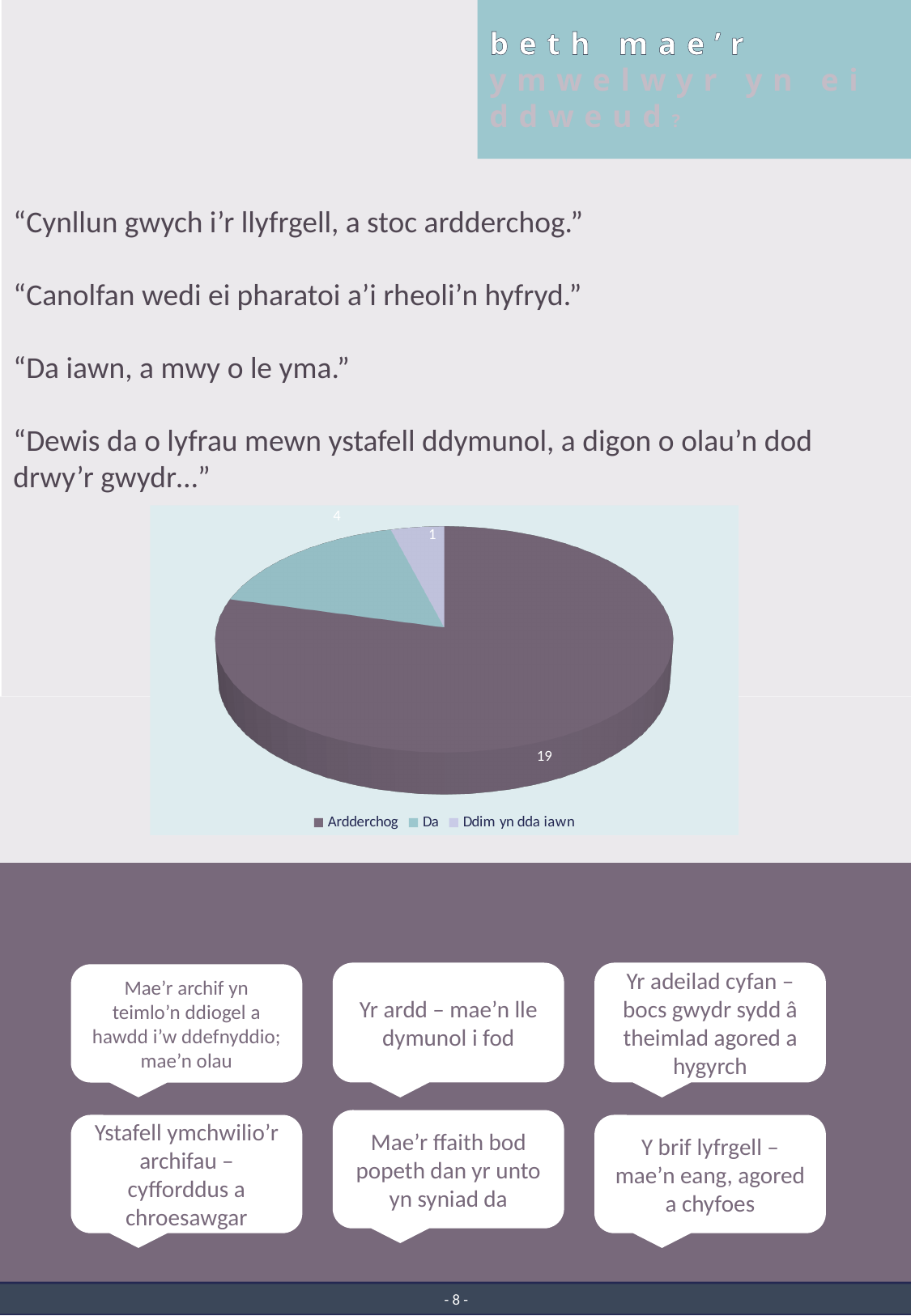
What is the total of all the slices in the pie chart? 24 Which legend entry is shown in the darkest colour in the pie chart? Ardderchog What is the value for Ddim yn dda iawn in the pie chart? 1 Which is larger, the value for Da or the value for Ddim yn dda iawn? Da What is the value for Da in the pie chart? 4 What is the value for Ardderchog in the pie chart? 19 What is the difference between the values for Da and Ddim yn dda iawn? 3 What type of chart is shown on the slide? pie chart What is the difference between the values for Ardderchog and Da? 15 Which category has the largest slice in the pie chart? Ardderchog Which category has the smallest slice in the pie chart? Ddim yn dda iawn How many categories does the pie chart show? 3